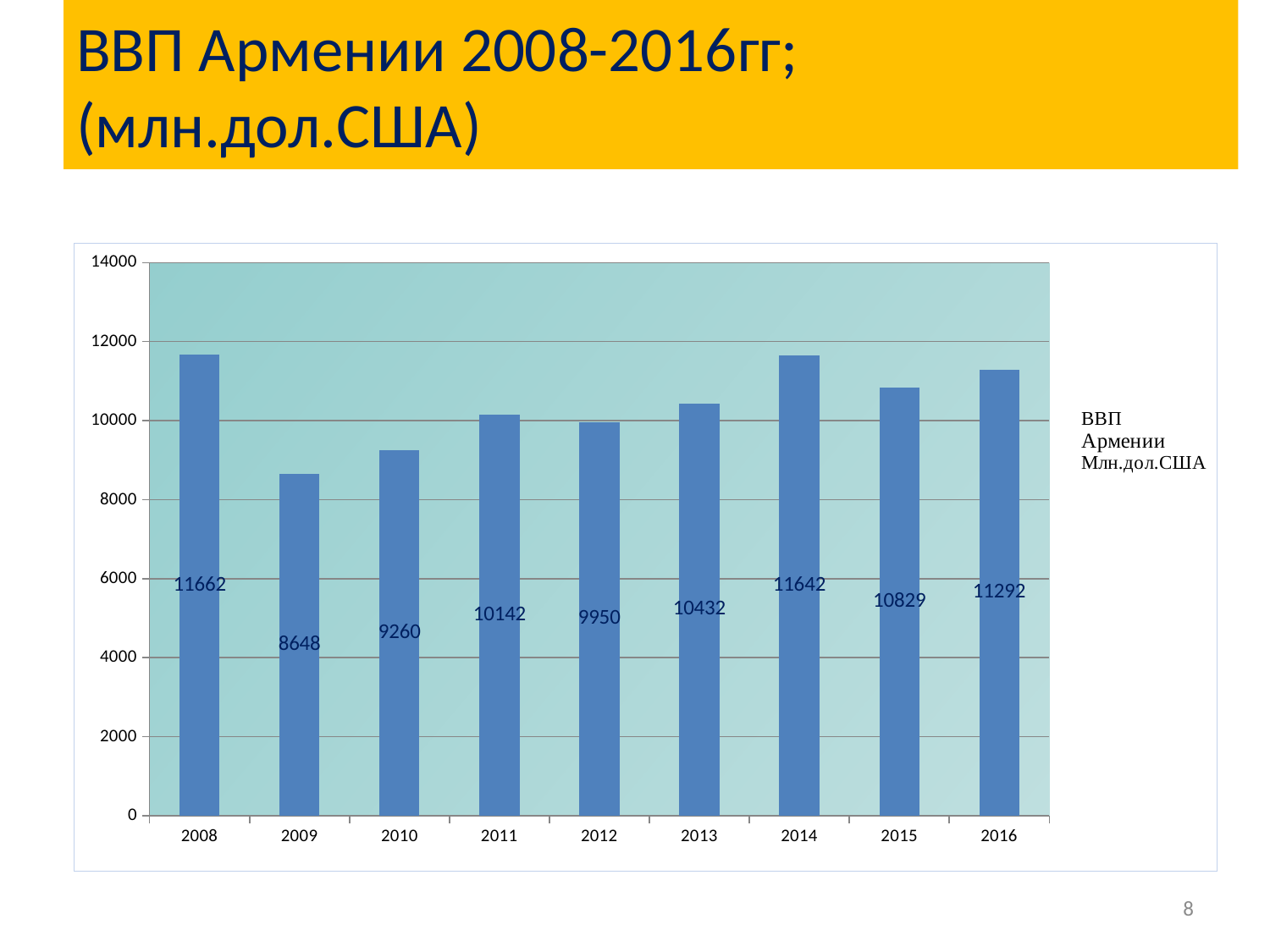
Which year has the lowest value? 2009 What is the value for 2016? 11292 Which year has the highest value? 2008 How many years are shown on the x axis? 9 Is the value for 2010 greater or less than 10000? less Which is larger, the value for 2015 or the value for 2011? 2015 What is the difference between the values for 2008 and 2009? 3014 What kind of chart is shown on the slide? bar chart What is the value for 2009? 8648 What is the value for 2014? 11642 What is the difference between the values for 2013 and 2012? 482